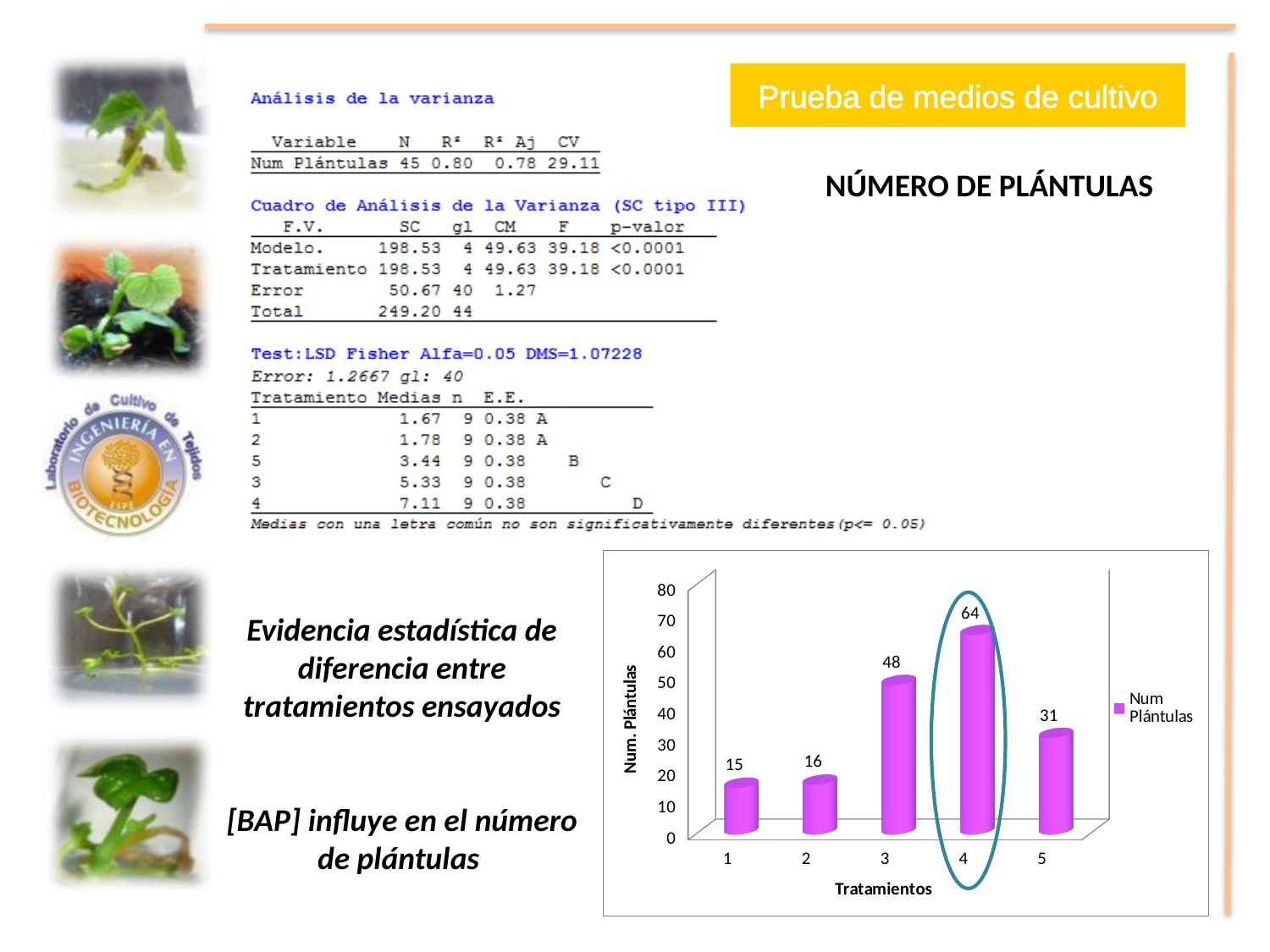
How many series does the legend of the bar chart list? 1 How many treatments are shown on the x axis of the bar chart? 5 What is the label of the y axis of the bar chart? Num. Plántulas Which treatment has the lowest number of plántulas in the bar chart? 1 What kind of chart is shown at the bottom right of the slide? bar chart What is the difference between the values for Tratamiento 4 and Tratamiento 3 in the bar chart? 16 Which treatment has the highest number of plántulas in the bar chart? 4 Which is larger in the bar chart, the value for Tratamiento 3 or Tratamiento 5? Tratamiento 3 What is the value for Tratamiento 5 in the bar chart? 31 What is the value for Tratamiento 1 in the bar chart? 15 What is the label of the x axis of the bar chart? Tratamientos What is the value for Tratamiento 4 in the bar chart? 64